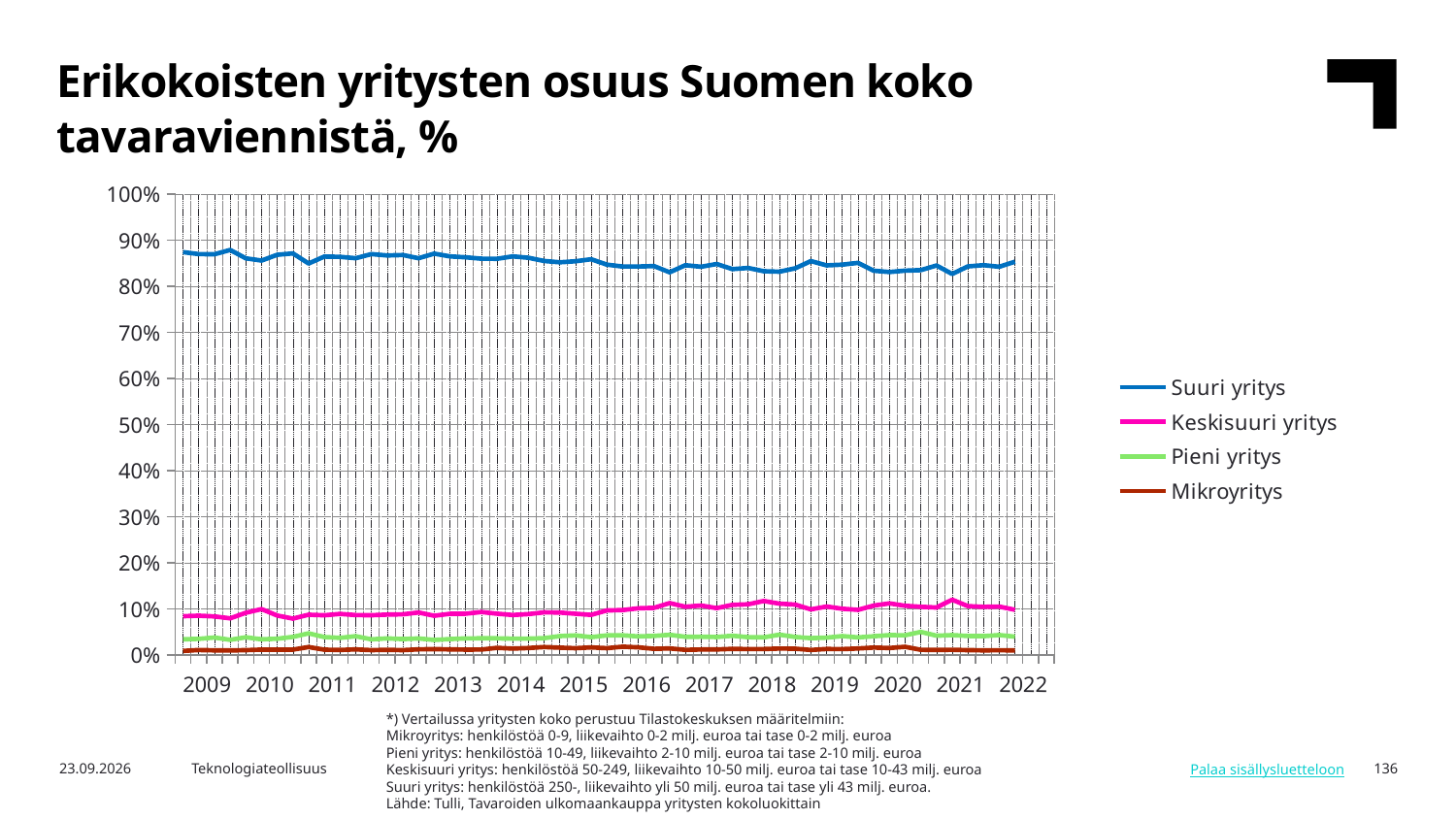
Is the value for Pieni yritys in 2015 greater or less than 10%? less Which series has the highest share throughout the period? Suuri yritys What is the title of the chart? Erikokoisten yritysten osuus Suomen koko tavaraviennistä, % How many series does the legend list? 4 How many years are labelled on the x axis? 14 Is the value for Keskisuuri yritys in 2022 greater or less than 20%? less Is the value for Suuri yritys in 2022 greater or less than 90%? less Which series is drawn with the blue line? Suuri yritys What kind of chart is shown on the slide? Line chart Which series has the lowest share throughout the period? Mikroyritys Which is larger in 2018: the share of Keskisuuri yritys or Pieni yritys? Keskisuuri yritys